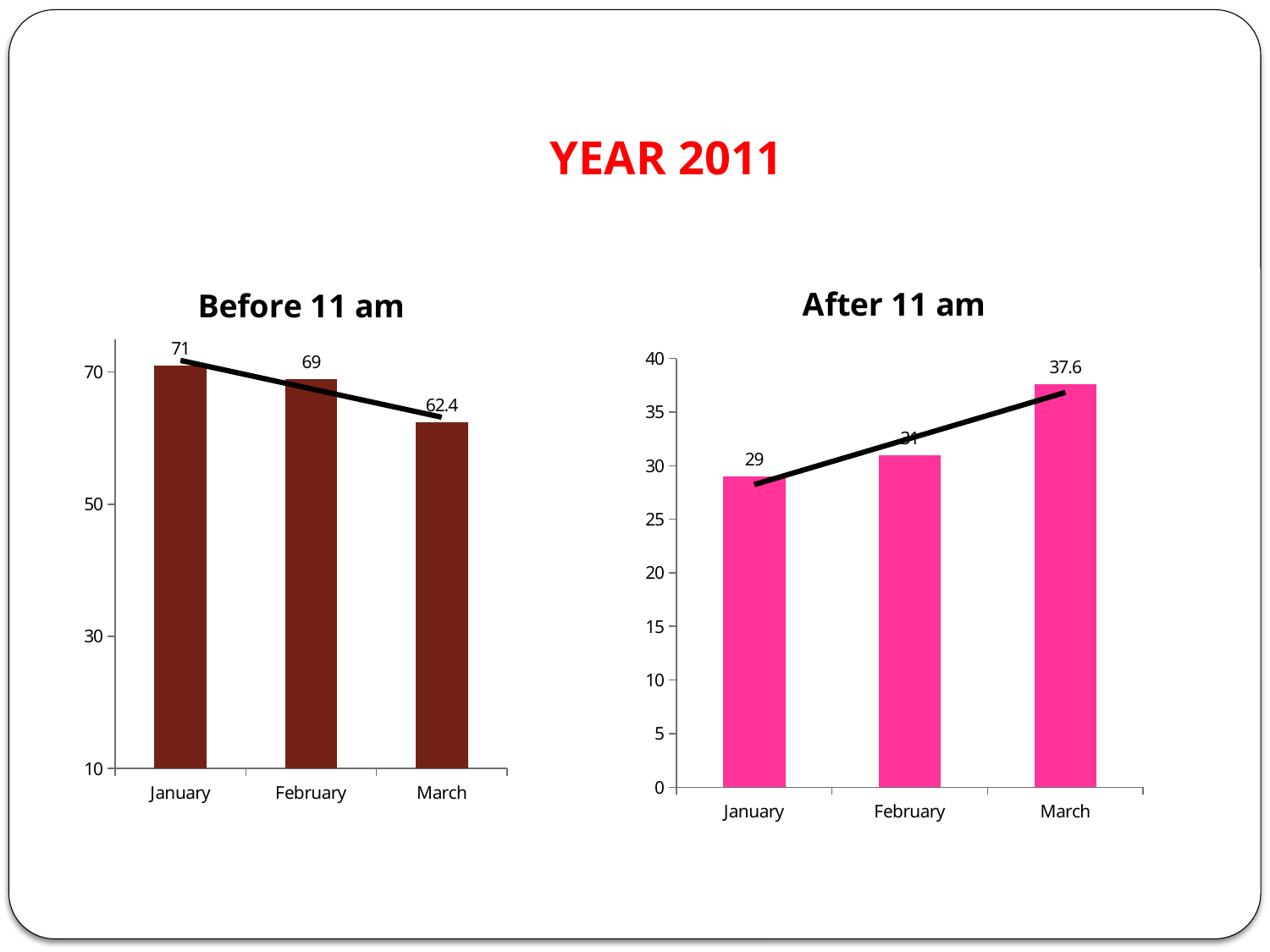
In the 'After 11 am' chart, what is the value for March? 37.6 In the 'Before 11 am' chart, do the values rise or fall from January to March? fall In the 'Before 11 am' chart, which month has the lowest value? March In the 'After 11 am' chart, what is the value for January? 29 In the 'Before 11 am' chart, what is the value for January? 71 What type of chart is the 'After 11 am' chart? bar chart In the 'Before 11 am' chart, what is the difference between the January and February values? 2 In the 'After 11 am' chart, which month has the highest value? March How many months are shown on the x axis of the 'Before 11 am' chart? 3 In the 'Before 11 am' chart, what is the value for March? 62.4 In the 'After 11 am' chart, is the value for February greater or less than 25? greater In the 'After 11 am' chart, do the values rise or fall from January to March? rise